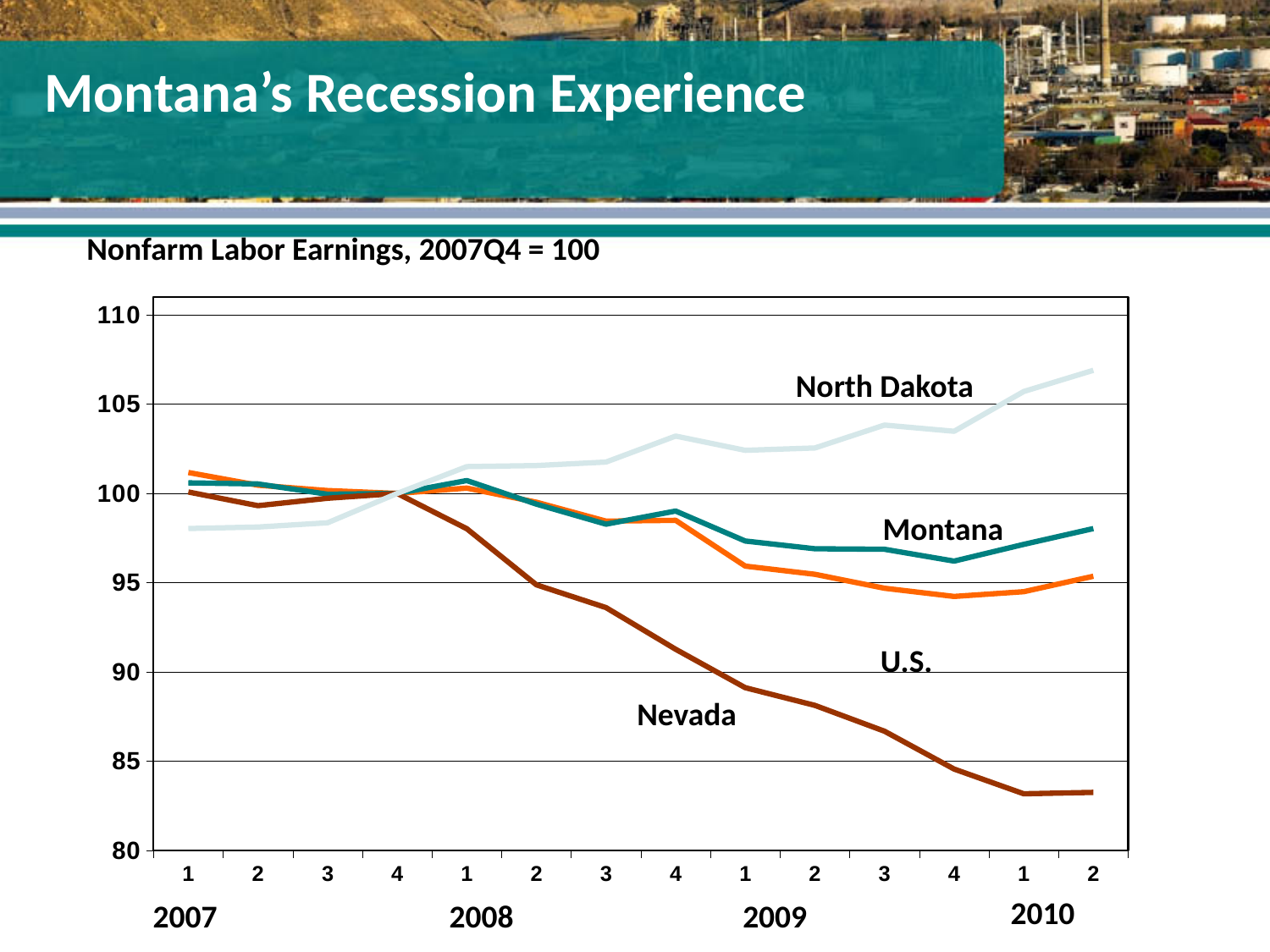
How many quarterly points are plotted along the x axis? 14 What is the title of the chart? Nonfarm Labor Earnings, 2007Q4 = 100 Does the North Dakota line rise or fall from 2007 Q1 to 2010 Q2? rise Is the value for Nevada at 2010 Q1 greater or less than 85? less How many series are plotted on the chart? 4 Which series has the lowest value at 2010 Q2? Nevada What kind of chart is shown on the slide? line chart At 2010 Q2, which is higher, Montana or U.S.? Montana Which series has the highest value at 2010 Q2? North Dakota Does the Nevada line rise or fall from 2008 Q1 to 2010 Q1? fall Is the value for North Dakota at 2010 Q2 greater or less than 105? greater Is the value for Montana at 2009 Q4 greater or less than 95? greater